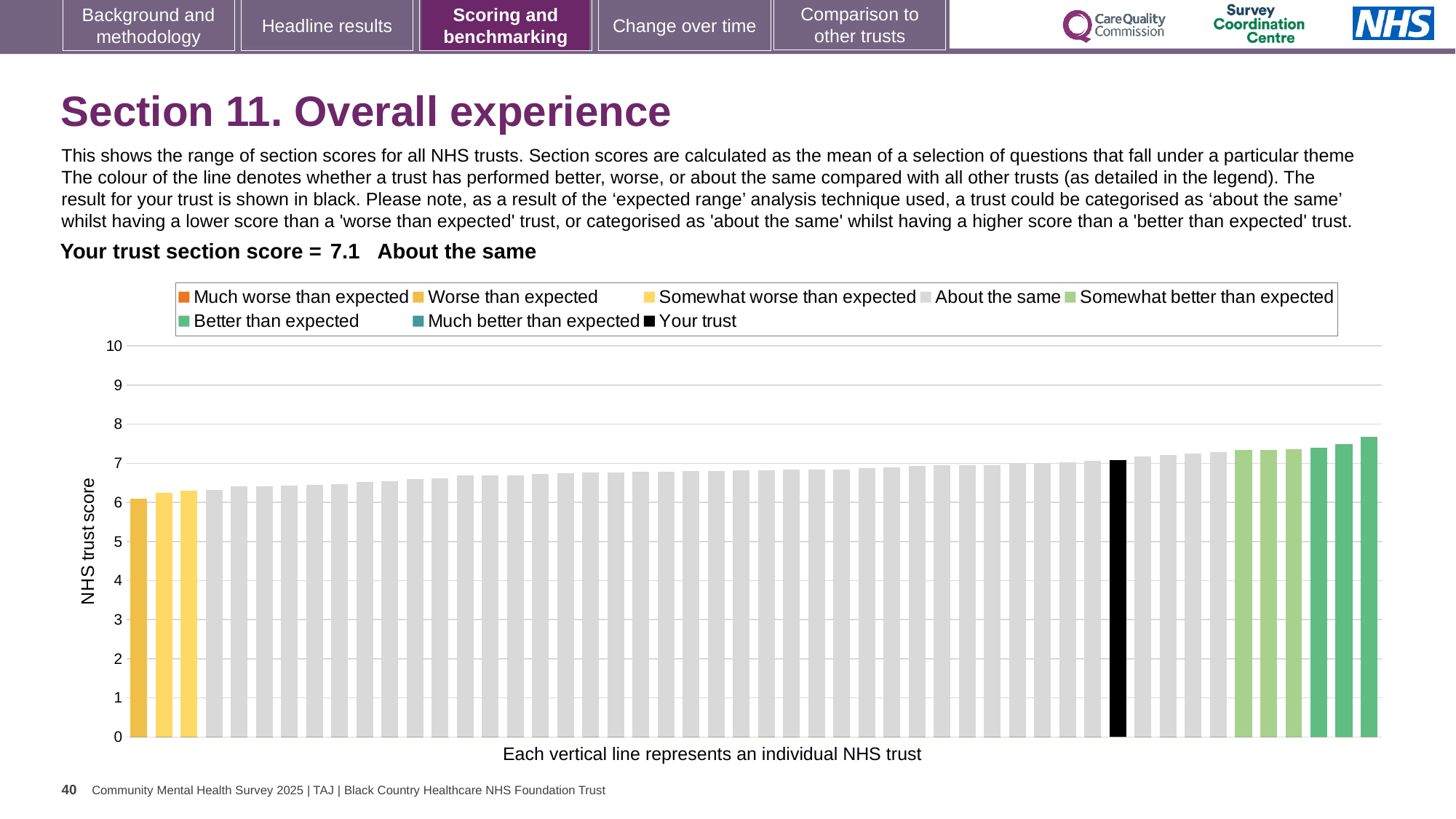
What kind of chart is shown on the slide? bar chart Is the score of the highest-scoring trust (rightmost bar) greater or less than 8? less How many entries does the chart legend list? 8 How many bars are shown in the 'Worse than expected' yellow colour? 1 Is your trust's bar higher or lower than the leftmost bar? higher Is the score of the lowest-scoring trust (leftmost bar) greater or less than 7? less How is your trust's score categorised compared with other trusts? About the same What is the label on the vertical axis of the chart? NHS trust score What is your trust's section score for Section 11, Overall experience? 7.1 Is the score of the lowest-scoring trust (leftmost bar) greater or less than 5? greater Do the trust scores rise or fall from left to right along the x axis? rise